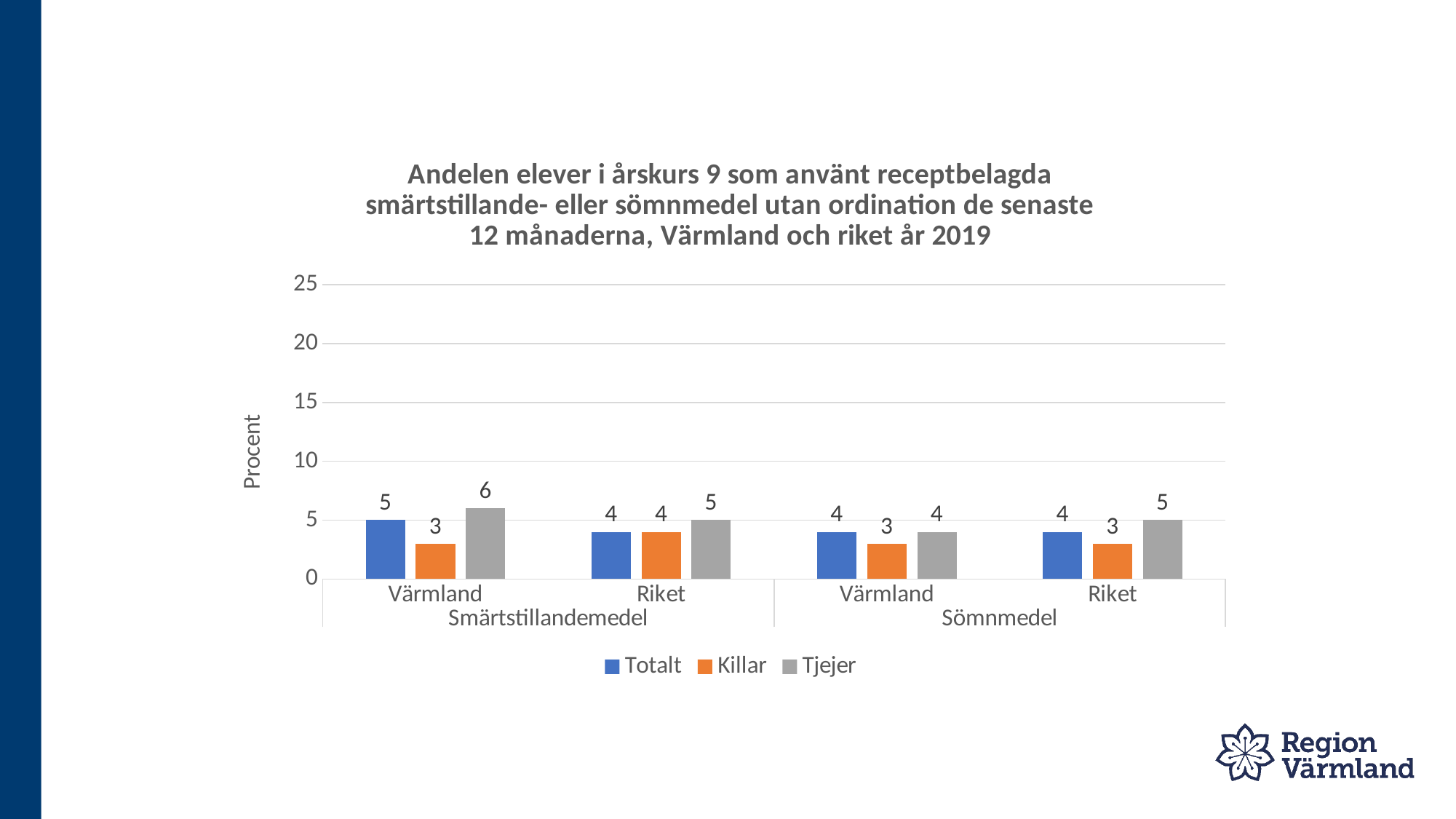
What kind of chart is shown on the slide? bar chart Which is larger for Värmland under Smärtstillandemedel: the Totalt value or the Killar value? Totalt How many series does the legend list? 3 Which colour represents the Killar series? orange What is the Tjejer value for Värmland under Smärtstillandemedel? 6 What is the difference between the Tjejer and Killar values for Värmland under Smärtstillandemedel? 3 What is the Totalt value for Värmland under Sömnmedel? 4 Which group has the highest Tjejer value? Värmland, Smärtstillandemedel What is the Tjejer value for Riket under Sömnmedel? 5 What is the label on the vertical axis? Procent What is the Killar value for Riket under Smärtstillandemedel? 4 Is the Tjejer value for Värmland under Smärtstillandemedel greater or less than 10? less